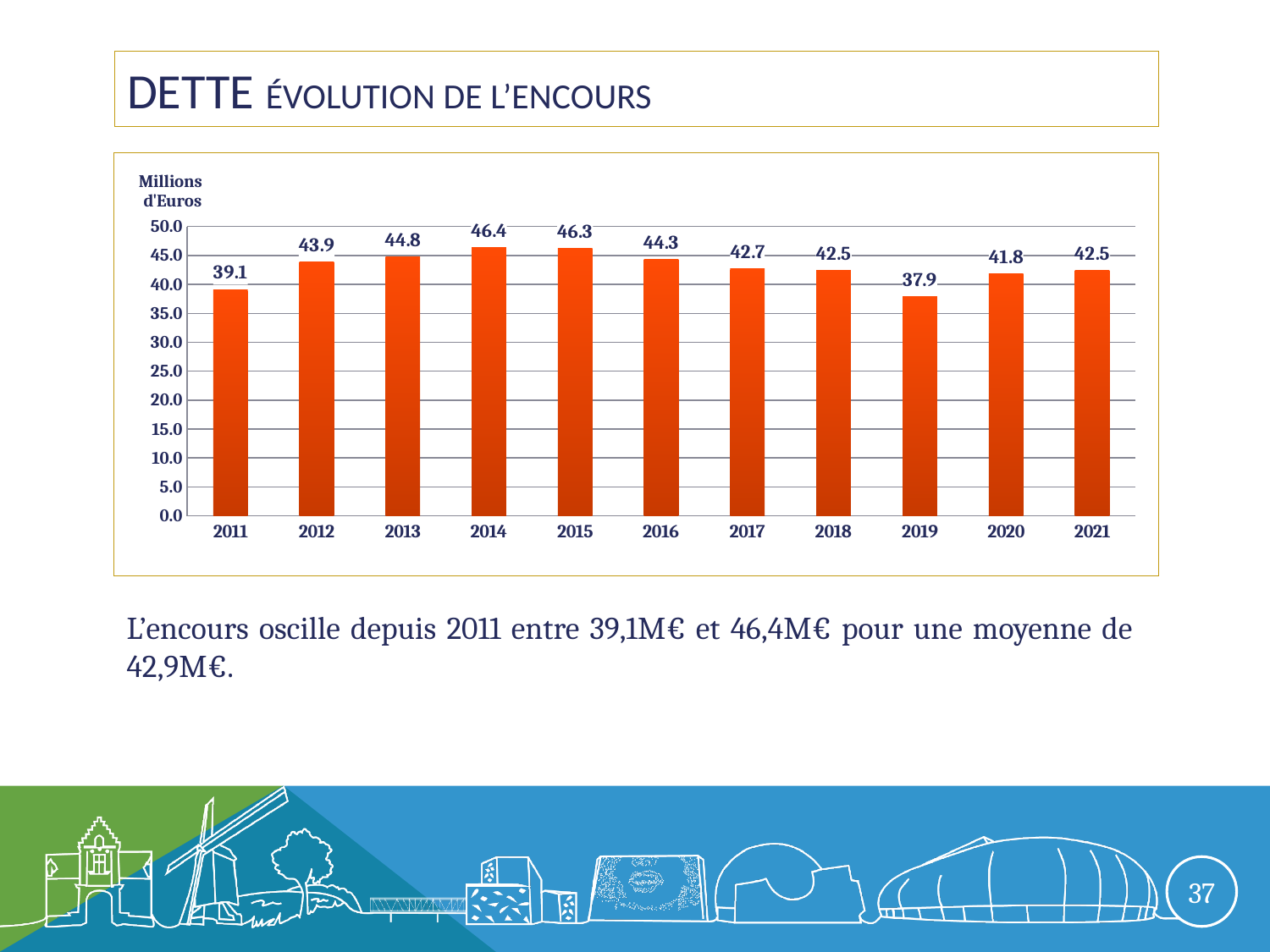
What kind of chart is shown? bar chart What is the difference between the values for 2014 and 2019? 8.5 Which year has the highest value? 2014 What is the value for 2011? 39.1 Which year has the lowest value? 2019 How many years are shown on the x axis? 11 Is the value for 2017 greater or less than 40.0? greater Which is larger, the value for 2013 or the value for 2016? 2013 What unit is given on the y axis label? Millions d'Euros Do the values rise or fall from 2011 to 2014? rise What is the value for 2019? 37.9 What is the value for 2014? 46.4